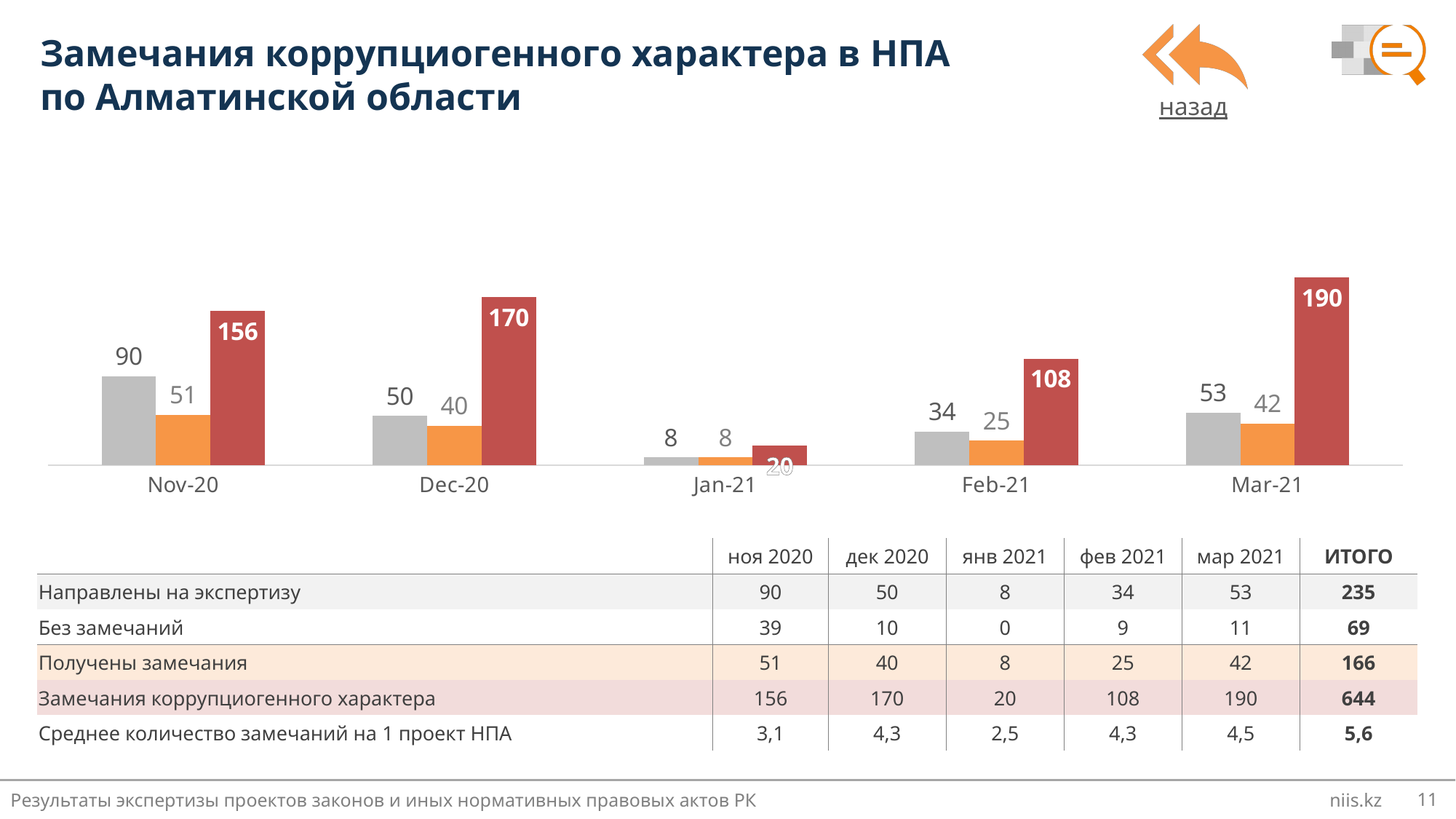
What is the value of the red bar (Замечания коррупциогенного характера) for Mar-21? 190 What is the value of the grey bar (Направлены на экспертизу) for Nov-20? 90 In which month is the grey bar (Направлены на экспертизу) the lowest? Jan-21 What colour are the bars representing Замечания коррупциогенного характера in the chart? red What is the difference between the grey bar and the orange bar for Dec-20? 10 Which is larger: the orange bar for Nov-20 or the orange bar for Mar-21? Nov-20 In which month is the red bar (Замечания коррупциогенного характера) the highest? Mar-21 What type of chart is shown on the slide? bar chart What is the value of the orange bar (Получены замечания) for Feb-21? 25 How many months (categories) are shown on the x axis of the chart? 5 What is the difference between the red bar values for Dec-20 and Nov-20? 14 Do the red bar values rise or fall from Jan-21 to Mar-21? rise